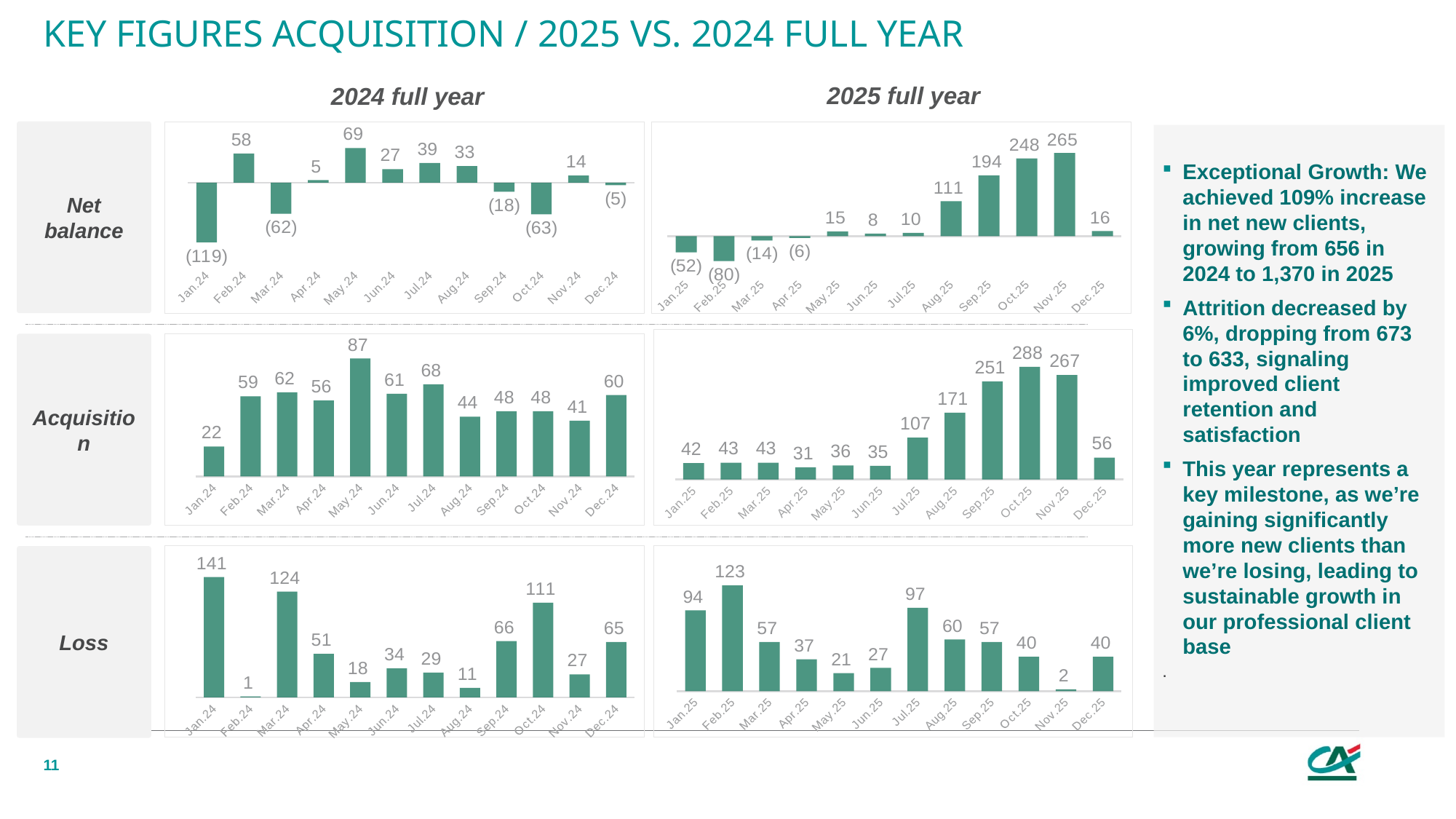
In the Loss 2024 full year chart, what is the value for Feb.24? 1 In the Loss 2025 full year chart, what is the difference between the values for Feb.25 and Jan.25? 29 In the Net balance 2025 full year chart, which month has the highest value? Nov.25 In the Acquisition 2025 full year chart, which is larger, the value for Jul.25 or the value for Dec.25? Jul.25 In the Loss 2025 full year chart, which month has the lowest value? Nov.25 In the Net balance 2025 full year chart, what is the value for Aug.25? 111 In the Loss 2024 full year chart, which month has the highest value? Jan.24 In the Net balance 2024 full year chart, what is the value for Jan.24? (119) In the Acquisition 2024 full year chart, which month has the lowest value? Jan.24 How many months are plotted in the Acquisition 2024 full year chart? 12 In the Acquisition 2025 full year chart, what is the difference between the values for Oct.25 and Sep.25? 37 What kind of chart is used for the Net balance 2024 full year data? Bar chart